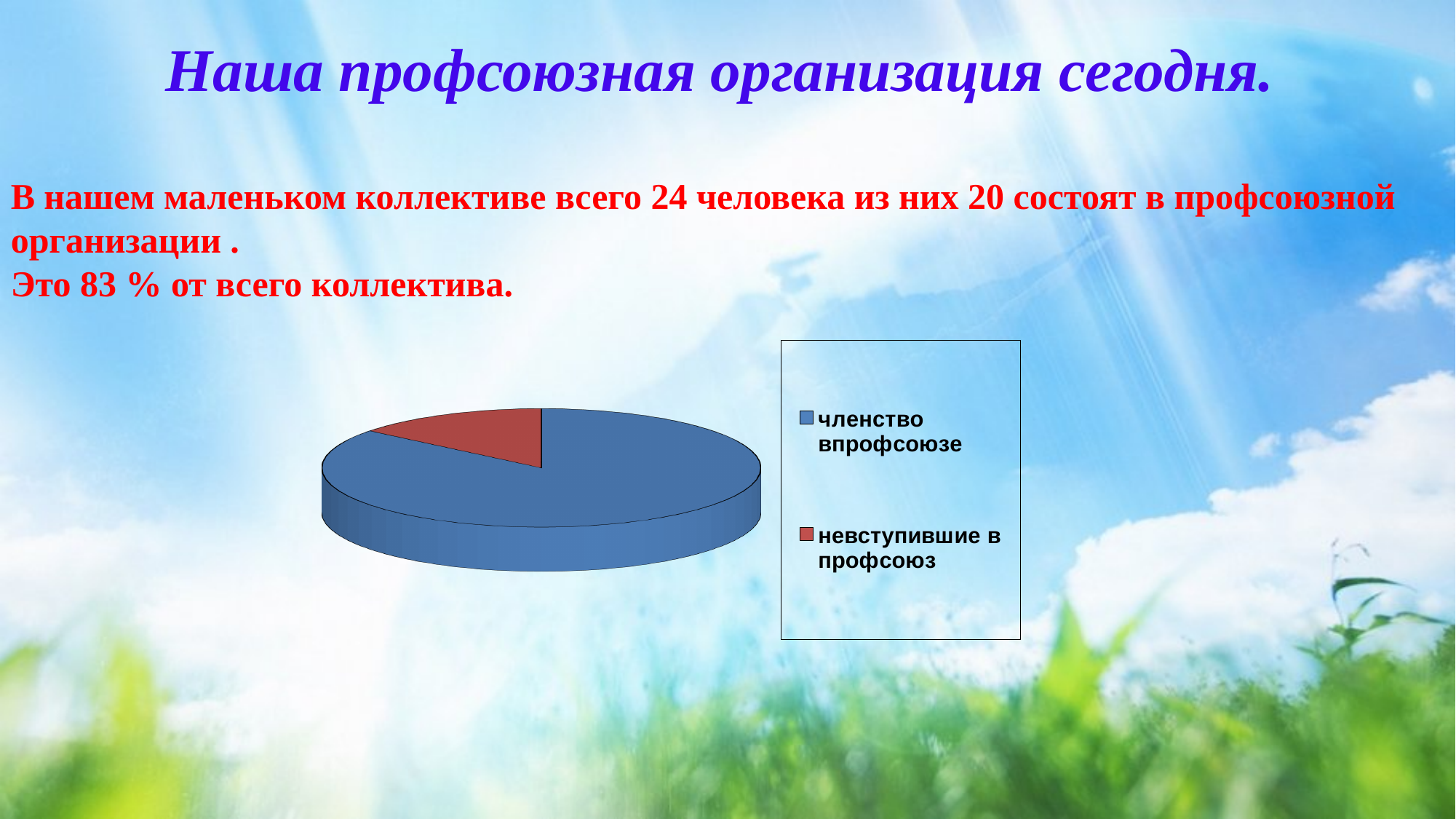
What colour is the slice for невступившие в профсоюз? red Which category has the smallest slice in the pie chart? невступившие в профсоюз How many entries does the legend of the pie chart list? 2 What colour is the slice for членство впрофсоюзе? blue Which category has the largest slice in the pie chart? членство впрофсоюзе How many slices does the pie chart have? 2 What kind of chart is shown on the slide? pie chart Which slice is larger: членство впрофсоюзе or невступившие в профсоюз? членство впрофсоюзе